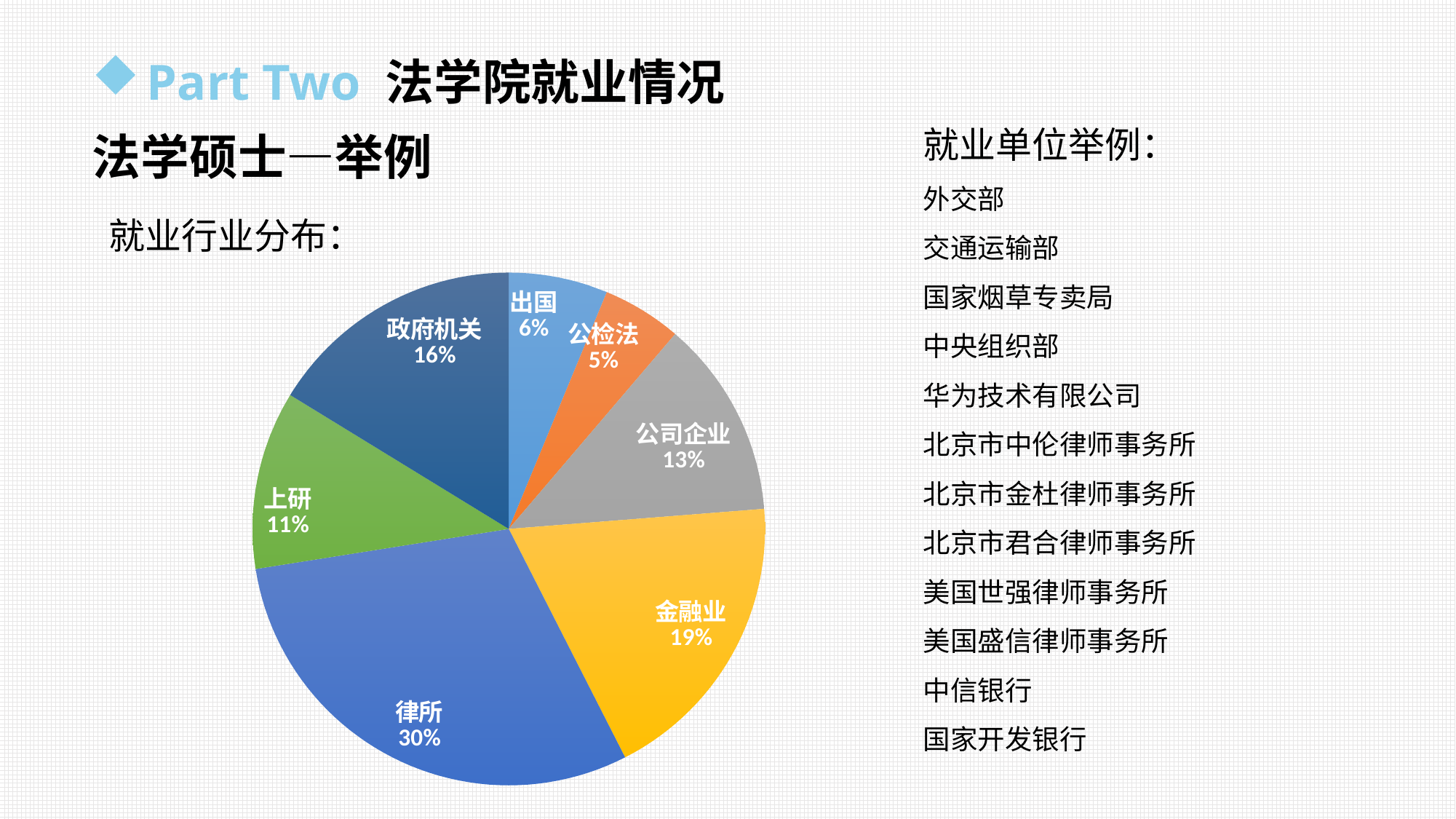
Which is larger, the share for 公司企业 or the share for 上研? 公司企业 What kind of chart is shown on the slide? pie chart What colour is the 金融业 slice? yellow What is the difference between the shares of 政府机关 and 出国? 10% What is the value shown for 政府机关? 16% Which category has the largest slice of the pie? 律所 What is the value shown for 金融业? 19% How many categories are shown in the pie chart? 7 Which category has the smallest slice of the pie? 公检法 What share of the pie does 律所 account for? 30% What is the value shown for 公检法? 5% What is the difference between the shares of 律所 and 金融业? 11%